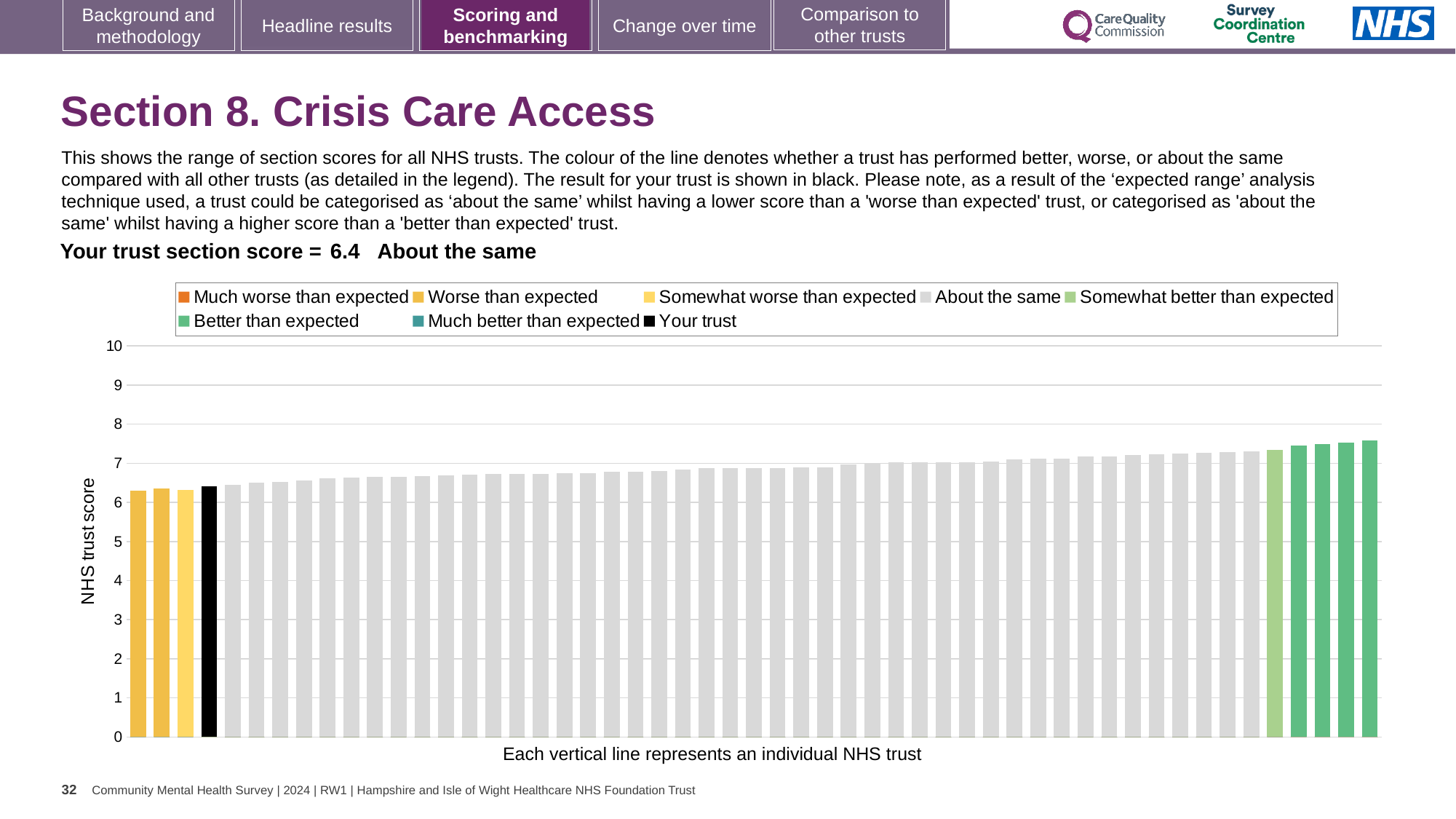
Do the bar values rise or fall from left to right along the x axis? rise What is the label on the vertical axis of the chart? NHS trust score How many entries does the chart legend list? 8 What kind of chart is shown on the slide? Bar chart How many bars are coloured as 'Worse than expected' (yellow)? 2 What is the section score for your trust shown on the slide? 6.4 Is the value of the highest bar in the chart greater or less than 8? less Which category is your trust's section score placed in? About the same Is the value for your trust (the black bar) greater or less than 5? greater Is the value of the lowest bar in the chart greater or less than 6? greater How many bars are coloured as 'Better than expected' (green)? 4 Which is larger: the value for your trust (black bar) or the value of the rightmost bar? The rightmost bar